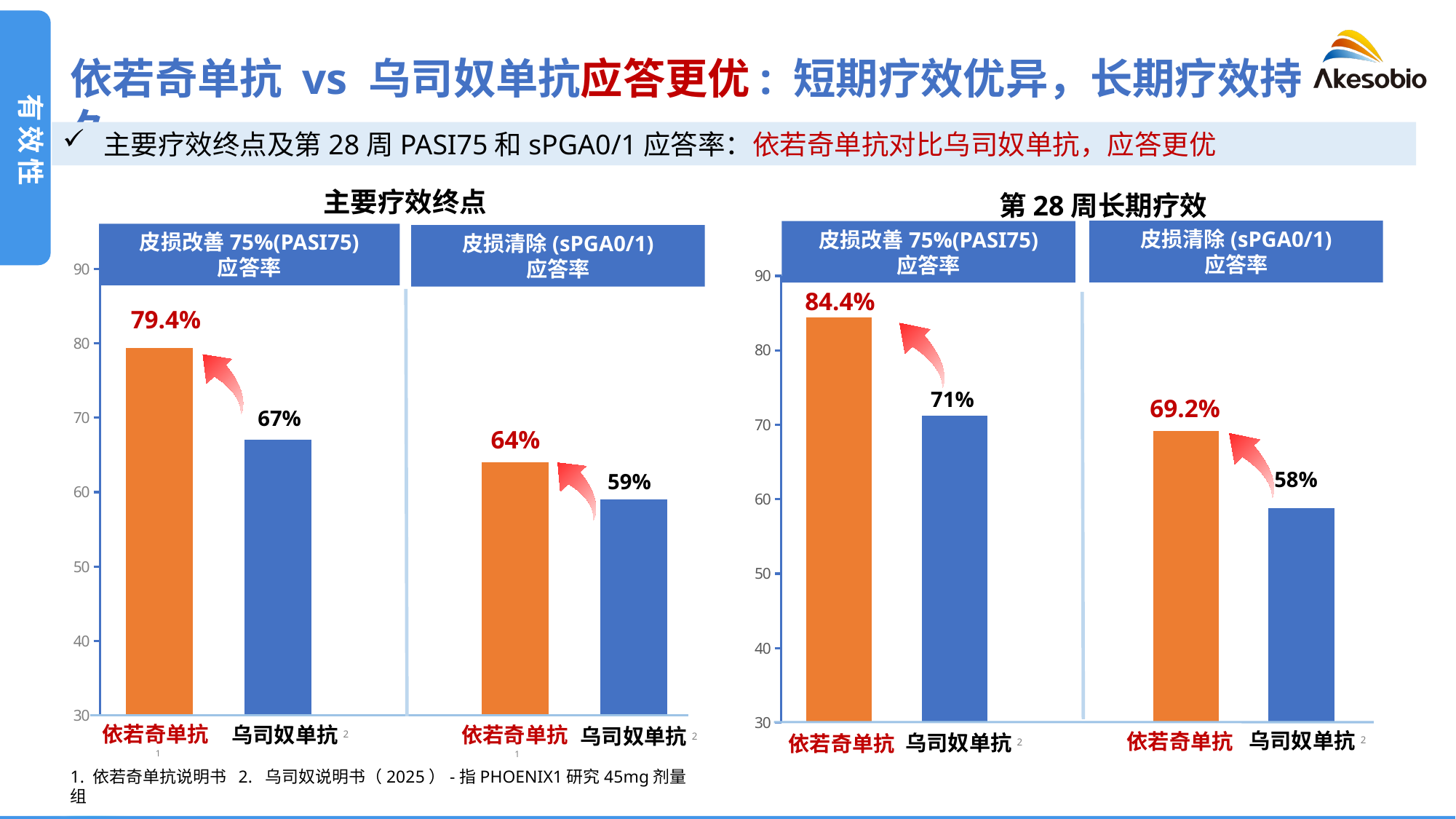
In the chart titled 第 28 周长期疗效, which bar is the highest? 依若奇单抗 PASI75 (84.4%) In the chart titled 第 28 周长期疗效, what is the sPGA0/1 response rate for 乌司奴单抗? 58% In the chart titled 主要疗效终点, what is the sPGA0/1 response rate for 乌司奴单抗? 59% In the chart titled 主要疗效终点, which bar is the lowest? 乌司奴单抗 sPGA0/1 (59%) In the chart titled 主要疗效终点, which has the higher sPGA0/1 response rate, 依若奇单抗 or 乌司奴单抗? 依若奇单抗 In the chart titled 第 28 周长期疗效, is the PASI75 value for 乌司奴单抗 greater or less than 80? less In the chart titled 第 28 周长期疗效, what is the PASI75 response rate for 依若奇单抗? 84.4% In the chart titled 主要疗效终点, what is the difference between the PASI75 response rates of 依若奇单抗 and 乌司奴单抗? 12.4% In the chart titled 第 28 周长期疗效, what is the difference between the sPGA0/1 response rates of 依若奇单抗 and 乌司奴单抗? 11.2% In the chart titled 主要疗效终点, what is the PASI75 response rate for 依若奇单抗? 79.4% In the chart titled 第 28 周长期疗效, how many bars are plotted in total? 4 What kind of chart is the chart titled 主要疗效终点? bar chart